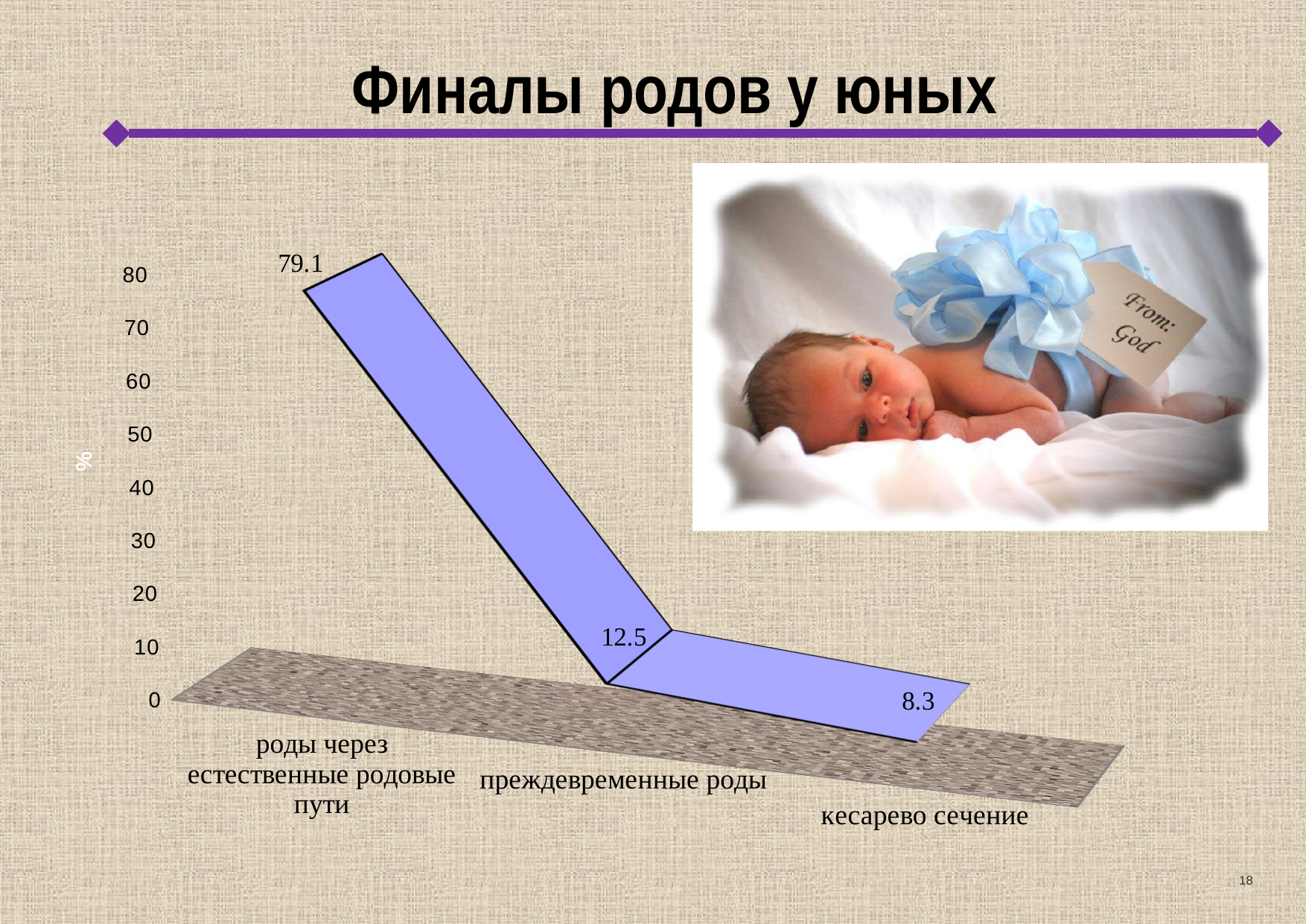
How many categories are shown on the x axis? 3 Which category has the highest value? роды через естественные родовые пути What is the value for преждевременные роды? 12.5 What is the difference between the values for роды через естественные родовые пути and преждевременные роды? 66.6 Is the value for роды через естественные родовые пути greater or less than 70? greater What is the label of the vertical axis? % Which category has the lowest value? кесарево сечение Do the values rise or fall from left to right along the x axis? fall Which is larger, the value for преждевременные роды or the value for кесарево сечение? преждевременные роды What is the value for кесарево сечение? 8.3 What is the value for роды через естественные родовые пути? 79.1 What is the difference between the values for преждевременные роды and кесарево сечение? 4.2